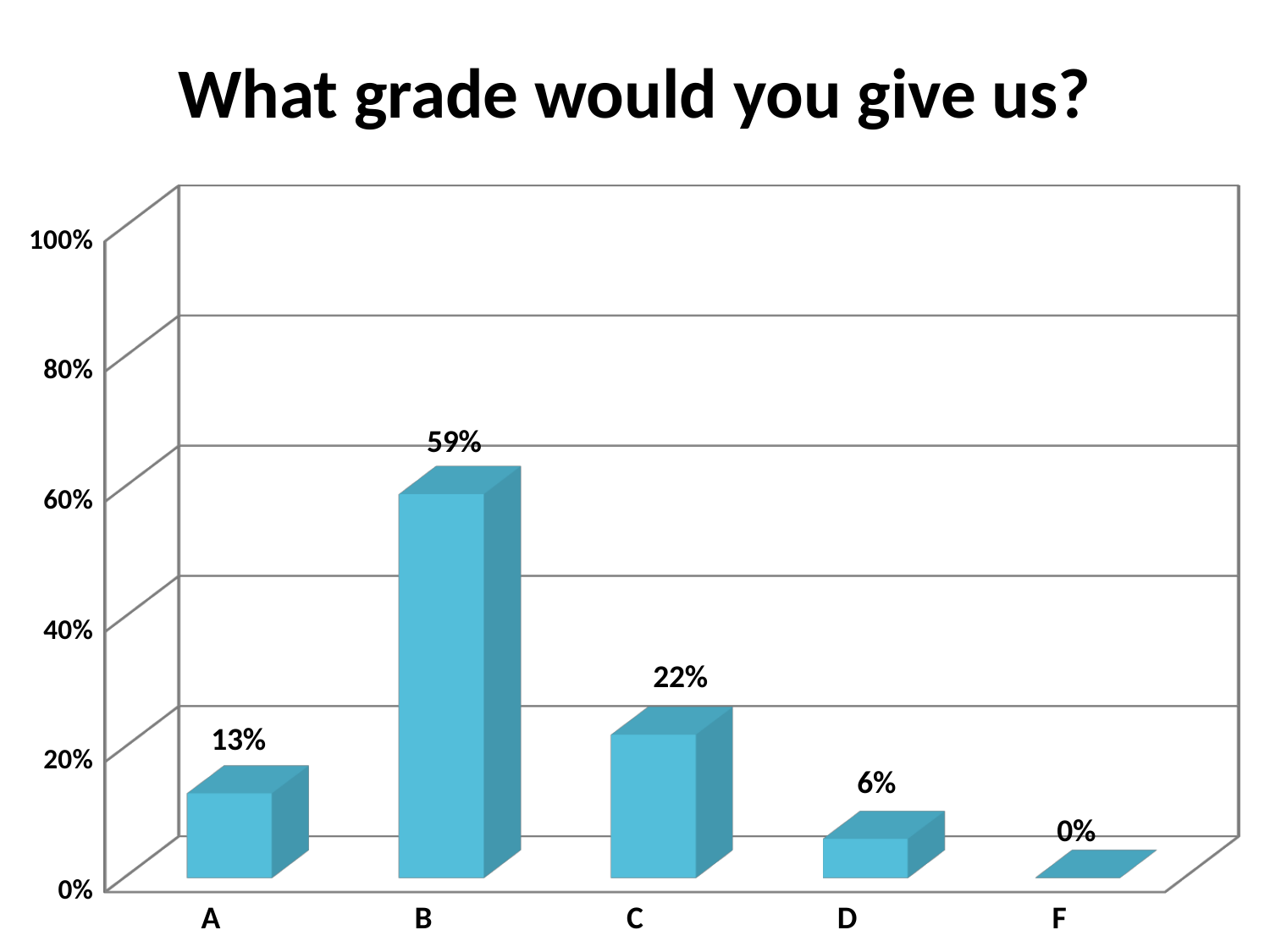
What kind of chart is shown on the slide? Bar chart What is the value shown for grade F? 0% What is the difference between the percentages for grade B and grade C? 37% What is the difference between the percentages for grade A and grade D? 7% What percentage of respondents gave a grade of B? 59% What is the value shown for grade A? 13% Which is larger, the value for grade A or the value for grade C? C Which grade received the lowest percentage? F How many grade categories are shown on the x axis? 5 Which grade received the highest percentage? B What percentage gave a grade of D? 6% What is the title of the chart? What grade would you give us?